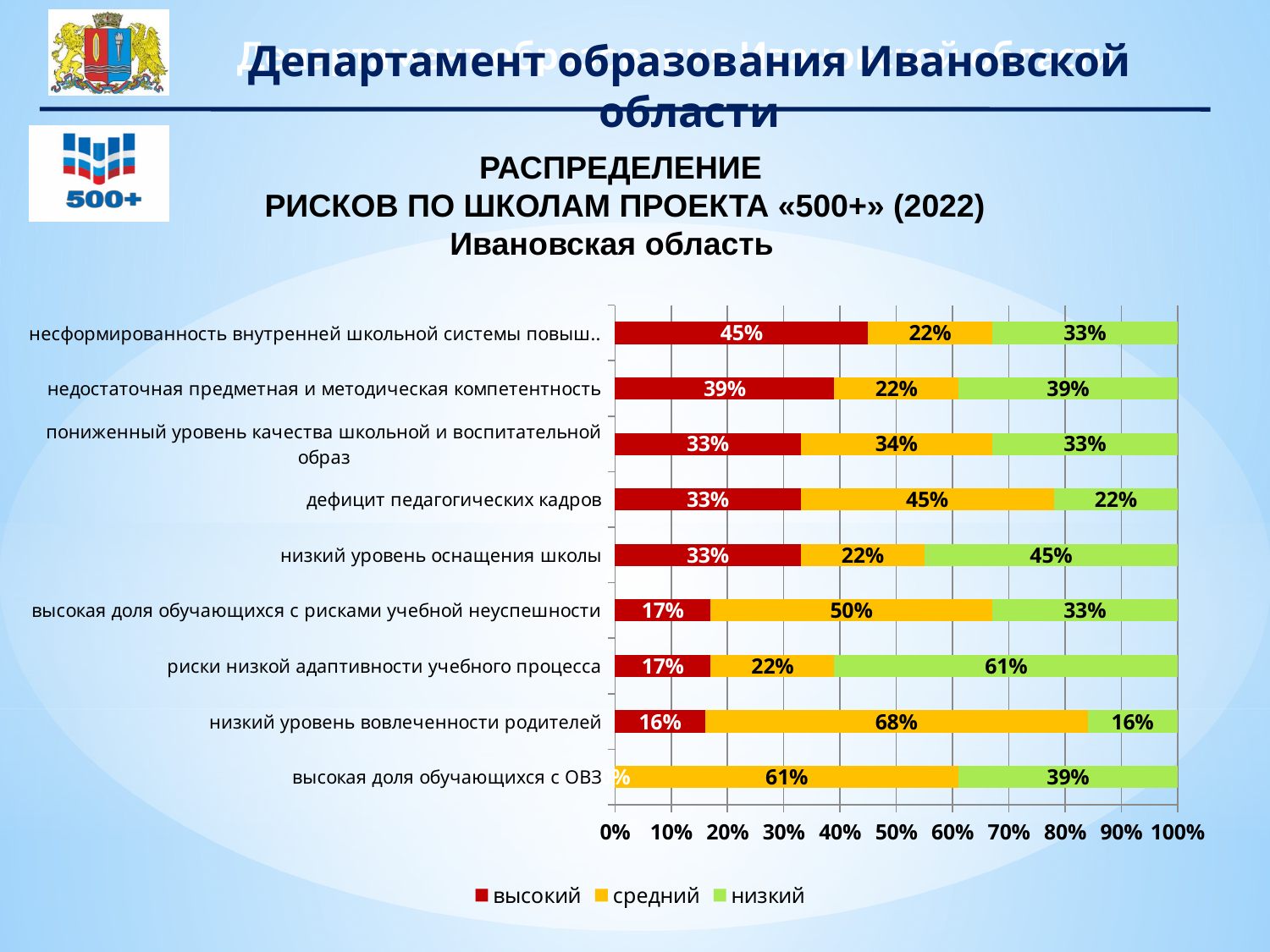
Which colour represents the 'средний' series in the legend? Orange/yellow How many series does the legend list? 3 What is the value of the 'средний' series for 'высокая доля обучающихся с рисками учебной неуспешности'? 50% What kind of chart is shown on the slide? Stacked bar chart Which category has the highest value in the 'высокий' series? несформированность внутренней школьной системы повыш.. What is the value of the 'высокий' series for 'дефицит педагогических кадров'? 33% What is the value of the 'средний' series for 'низкий уровень вовлеченности родителей'? 68% How many categories (risk types) are shown on the chart? 9 Which is larger: the 'низкий' value for 'низкий уровень оснащения школы' or the 'низкий' value for 'дефицит педагогических кадров'? низкий уровень оснащения школы Which category has the lowest value in the 'низкий' series? низкий уровень вовлеченности родителей What is the value of the 'низкий' series for 'риски низкой адаптивности учебного процесса'? 61% What is the difference between the 'средний' values for 'низкий уровень вовлеченности родителей' and 'дефицит педагогических кадров'? 23%